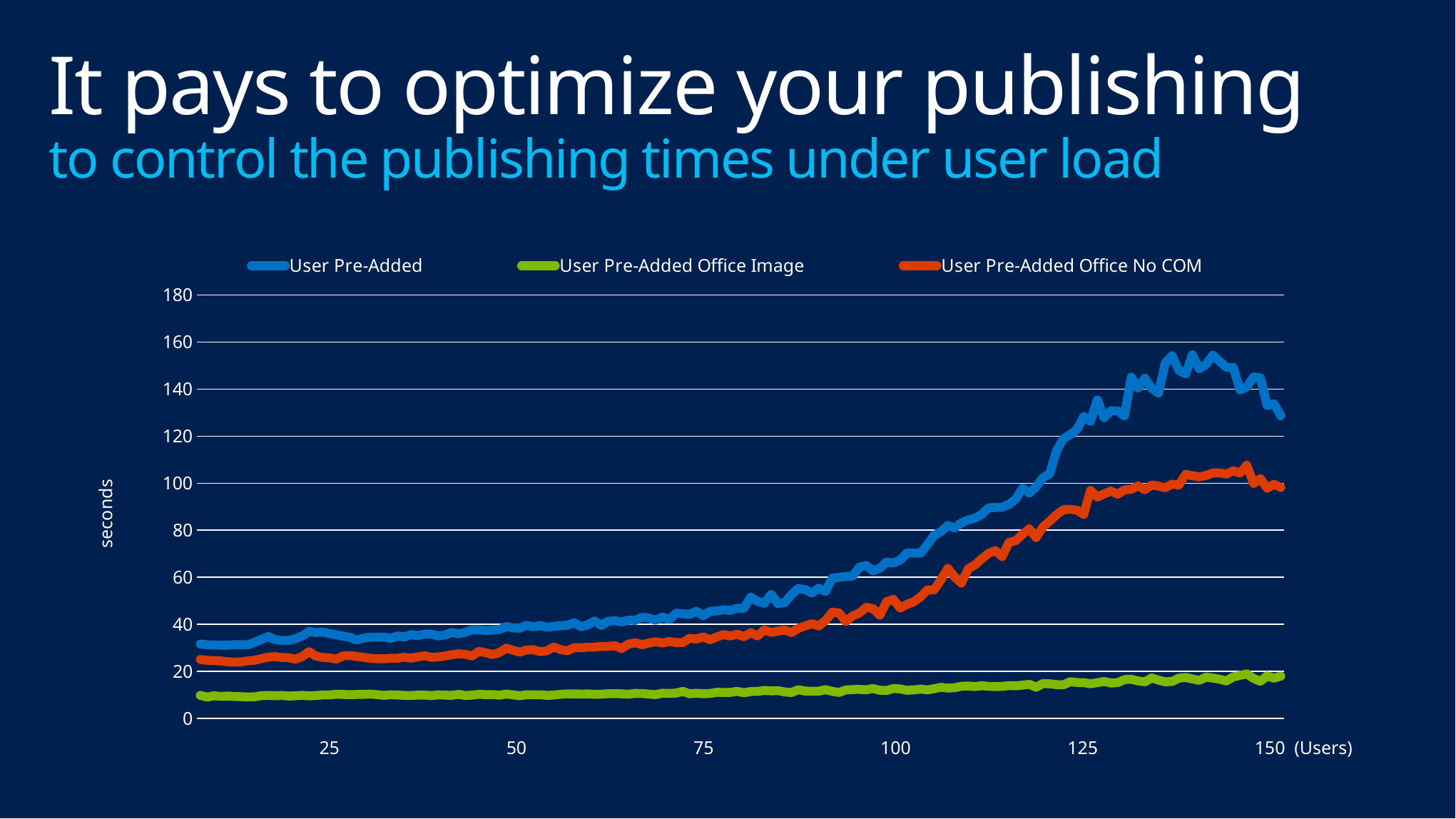
What is the label on the vertical axis of the chart? seconds Is the value for User Pre-Added at 25 users greater or less than 60? less Which series stays lowest across the whole range of users? User Pre-Added Office Image At 100 users, which series has the higher value, User Pre-Added or User Pre-Added Office Image? User Pre-Added Does the User Pre-Added Office No COM series rise or fall between 25 and 125 users? rise Which series reaches the highest value on the chart? User Pre-Added What kind of chart is shown on the slide? line chart How many series does the legend list? 3 Is the value for User Pre-Added Office Image at 150 users greater or less than 40? less Is the value for User Pre-Added at 150 users greater or less than 120? greater What unit is shown at the end of the horizontal axis? (Users)